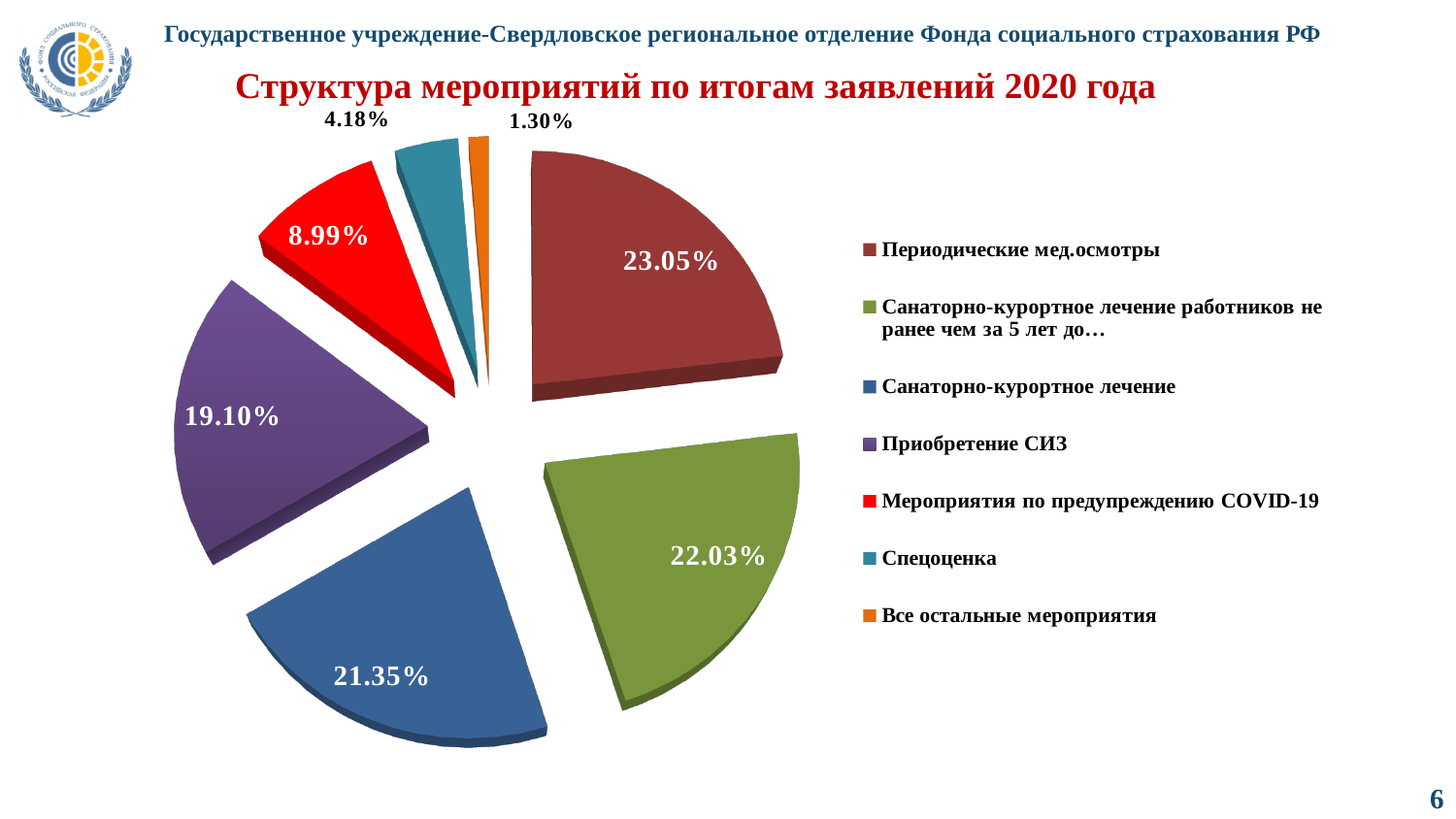
What is the share for Все остальные мероприятия? 1.30% What is the title of the chart? Структура мероприятий по итогам заявлений 2020 года What is the share for Спецоценка? 4.18% Which category has the largest share of the pie? Периодические мед.осмотры Which is larger: the share for Приобретение СИЗ or the share for Мероприятия по предупреждению COVID-19? Приобретение СИЗ What is the share for Мероприятия по предупреждению COVID-19? 8.99% What is the difference between the shares for Периодические мед.осмотры and Санаторно-курортное лечение? 1.70% What is the share for Приобретение СИЗ? 19.10% What is the share for Периодические мед.осмотры? 23.05% How many categories does the legend list? 7 Which category has the smallest share of the pie? Все остальные мероприятия What kind of chart is shown on the slide? pie chart